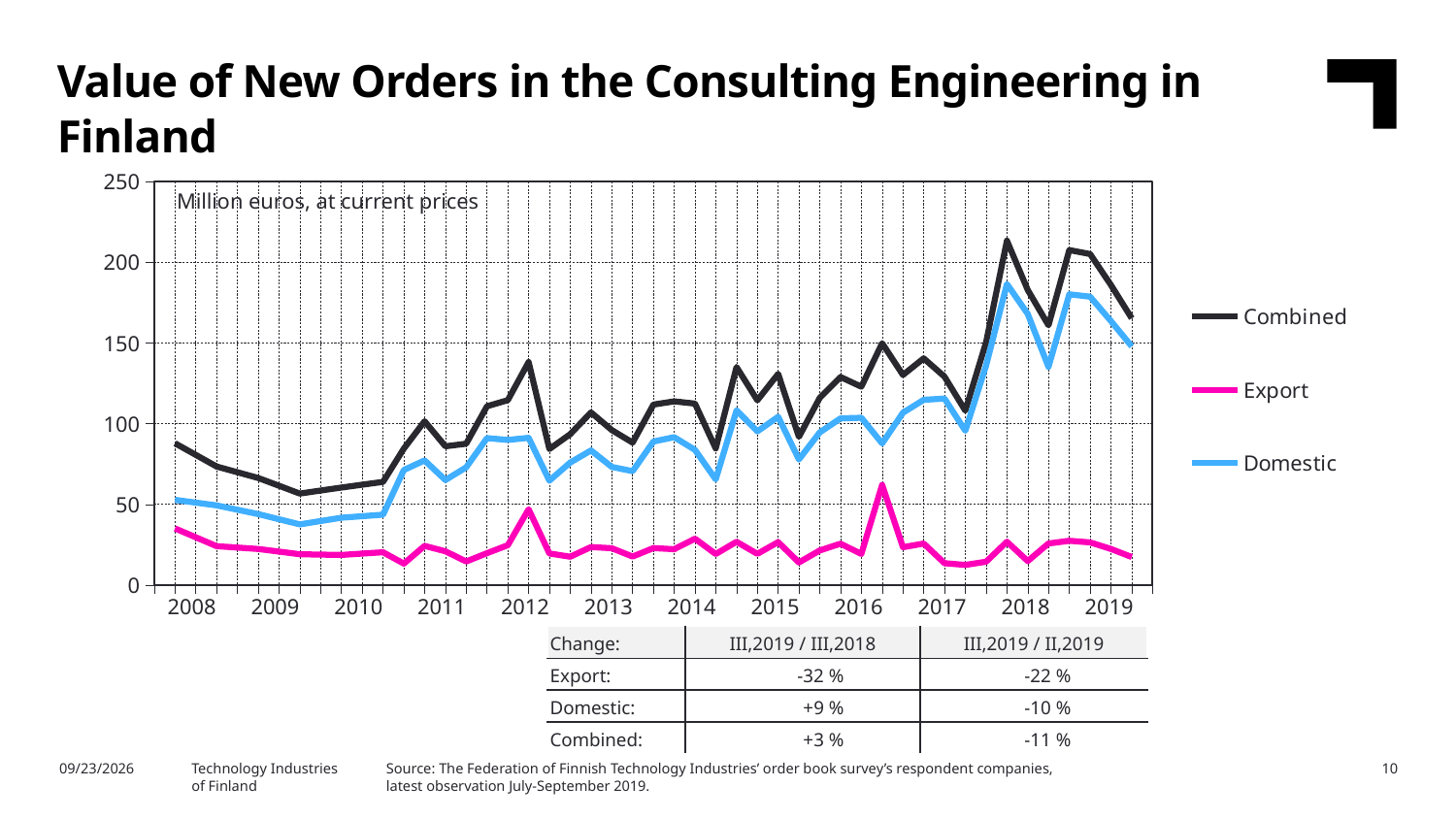
Which series has the highest values throughout the chart? Combined What type of chart is shown on the slide? line chart Which series has the lowest values throughout the chart? Export What unit is stated inside the chart area? Million euros, at current prices Does the Combined series overall rise or fall from 2008 to 2019? rise Is the peak value of the Combined series in late 2017 greater or less than 200? greater Is the peak value of the Export series in 2016 greater or less than 50? greater According to the table below the chart, what is the Export change for III,2019 / III,2018? -32 % Is the value of the Domestic series at the start of 2009 greater or less than 50? less How many series does the legend list? 3 What is the title of the chart? Value of New Orders in the Consulting Engineering in Finland